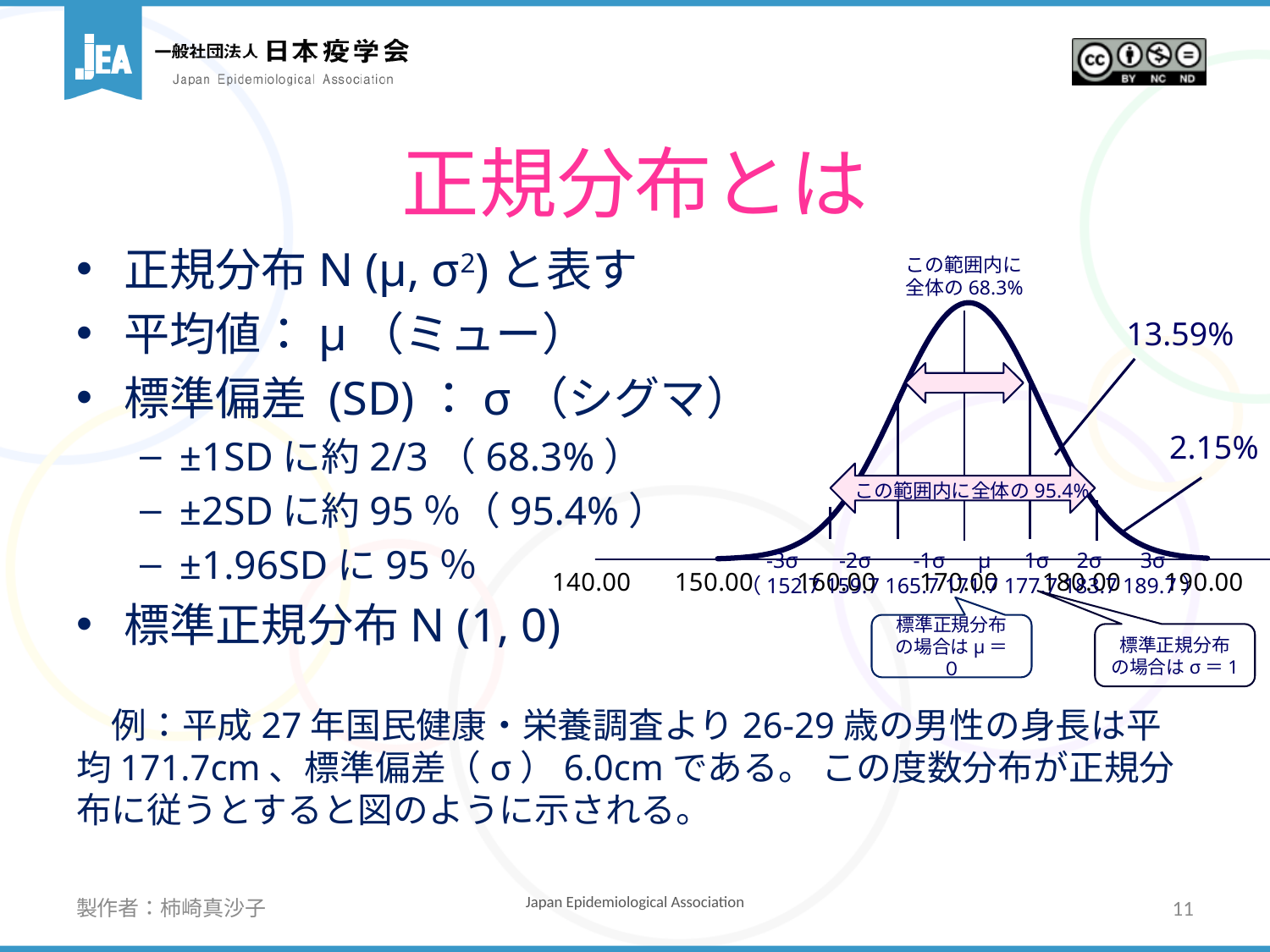
What is the largest tick value shown on the chart's x axis? 190.00 Does the curve rise or fall as x moves from μ toward 3σ? fall According to the chart annotation, what percentage of the total lies within ±1σ of the mean? 68.3% According to the callout boxes on the chart, what are μ and σ for the standard normal distribution? μ = 0, σ = 1 What kind of chart is shown on the right of the slide? line chart Which is larger, the percentage within ±2σ or the percentage within ±1σ? ±2σ (95.4%) How many numeric tick labels are shown on the chart's x axis? 6 What percentage label is attached to the region between 1σ and 2σ on the chart? 13.59% What percentage label is attached to the tail region beyond 2σ on the chart? 2.15% According to the chart annotation, what percentage of the total lies within ±2σ of the mean? 95.4% At which labelled point does the curve reach its peak? μ What is the smallest tick value shown on the chart's x axis? 140.00